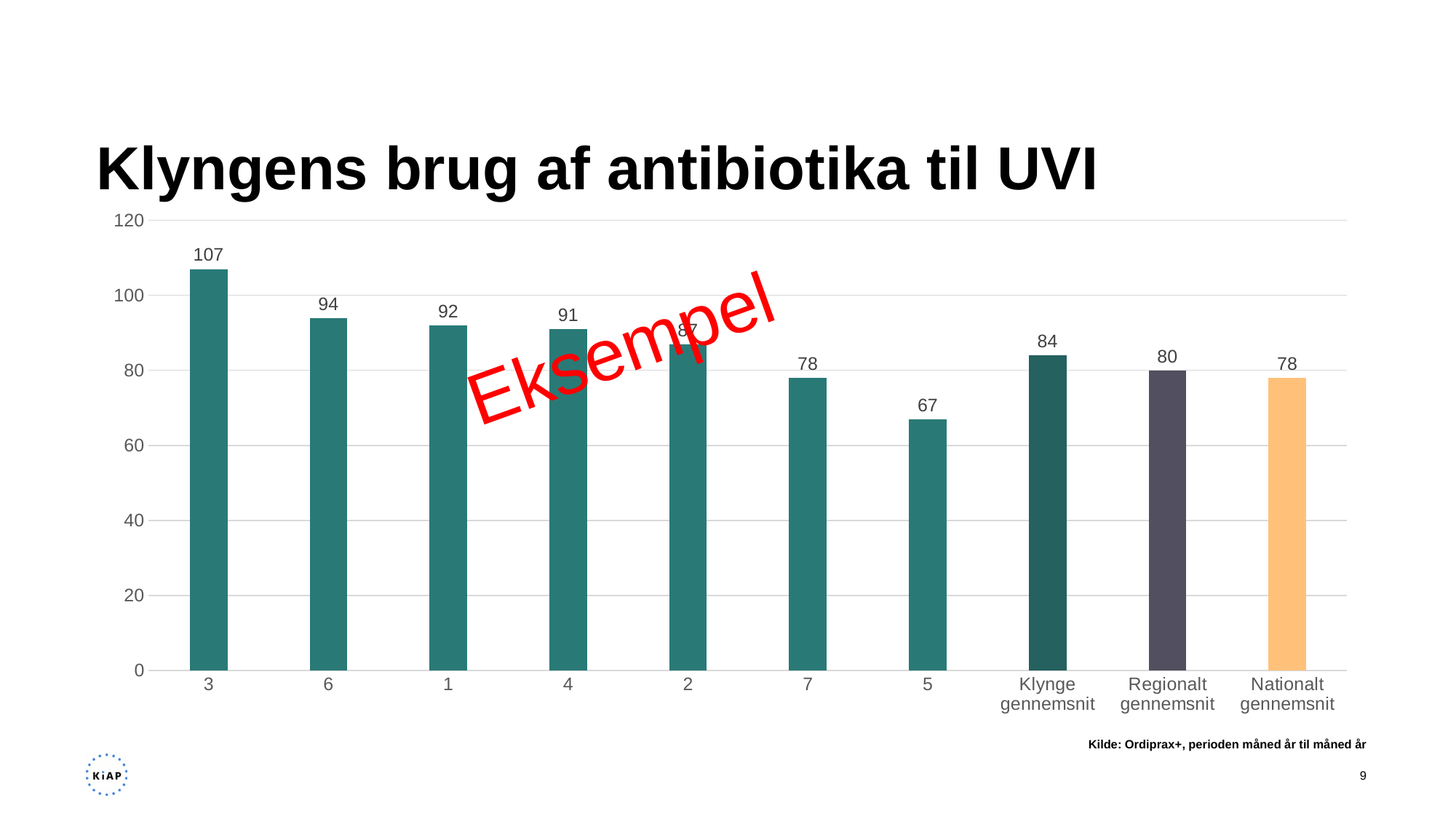
What is the value for Regionalt gennemsnit? 80 What is the value for Nationalt gennemsnit? 78 What kind of chart is shown on the slide? bar chart What is the value for practice 3? 107 What is the difference between the values for practice 3 and practice 5? 40 Which category has the lowest value? 5 What is the value for Klynge gennemsnit? 84 How many bars are shown in the chart? 10 Which is larger, Regionalt gennemsnit or Nationalt gennemsnit? Regionalt gennemsnit What is the difference between Klynge gennemsnit and Nationalt gennemsnit? 6 Is the value for practice 2 greater or less than 80? greater Which category has the highest value? 3